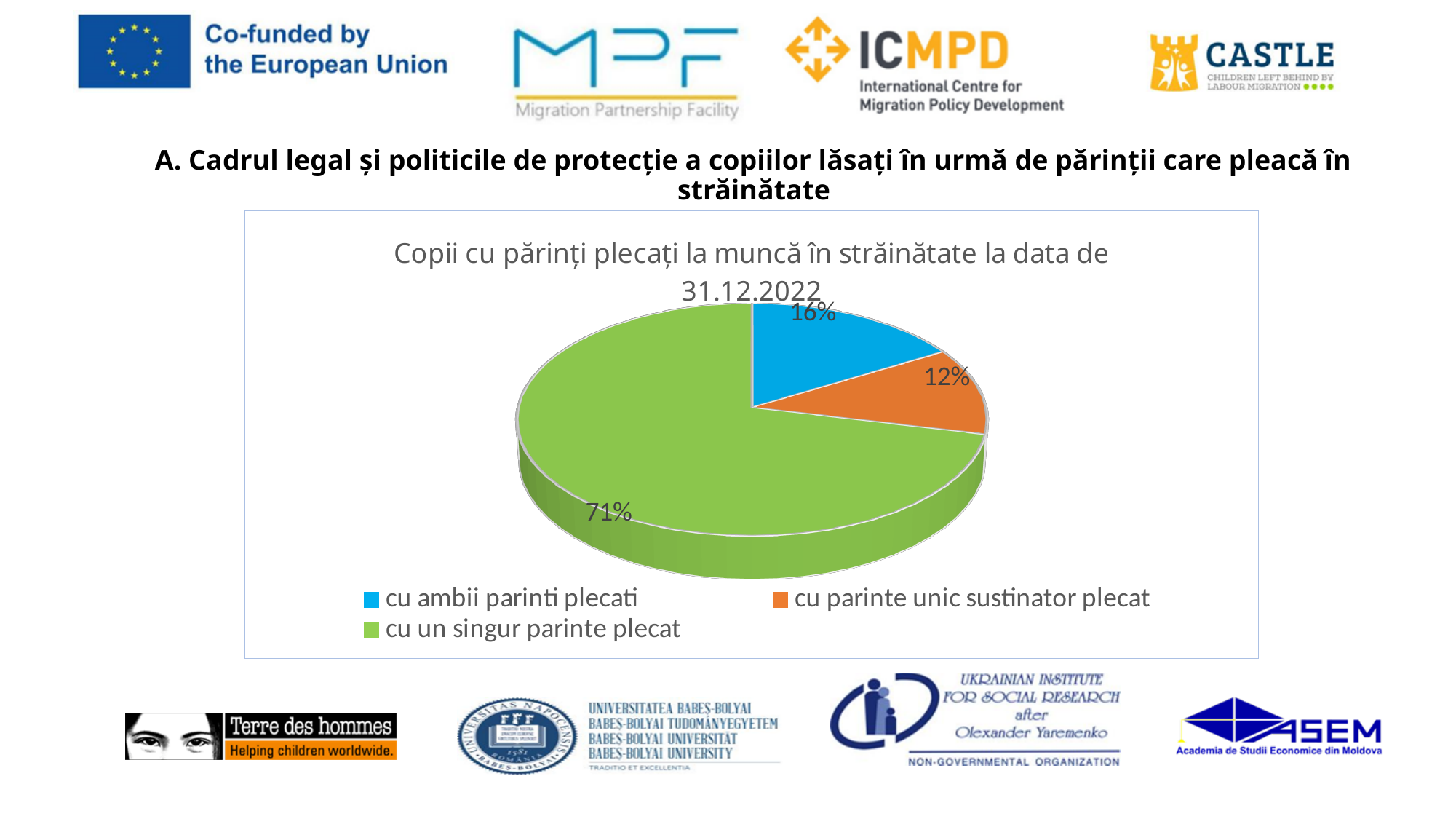
What colour is the slice for 'cu parinte unic sustinator plecat'? orange What is the title of the chart? Copii cu părinți plecați la muncă în străinătate la data de 31.12.2022 What share of the pie is 'cu ambii parinti plecati'? 16% What type of chart is shown on the slide? pie chart Which is larger: the share for 'cu ambii parinti plecati' or for 'cu parinte unic sustinator plecat'? cu ambii parinti plecati What share of the pie is 'cu parinte unic sustinator plecat'? 12% What share of the pie is 'cu un singur parinte plecat'? 71% What is the difference in percentage points between 'cu un singur parinte plecat' and 'cu ambii parinti plecati'? 55 Which category has the smallest share of the pie? cu parinte unic sustinator plecat How many categories does the pie chart show? 3 What is the difference in percentage points between 'cu ambii parinti plecati' and 'cu parinte unic sustinator plecat'? 4 Which category has the largest share of the pie? cu un singur parinte plecat